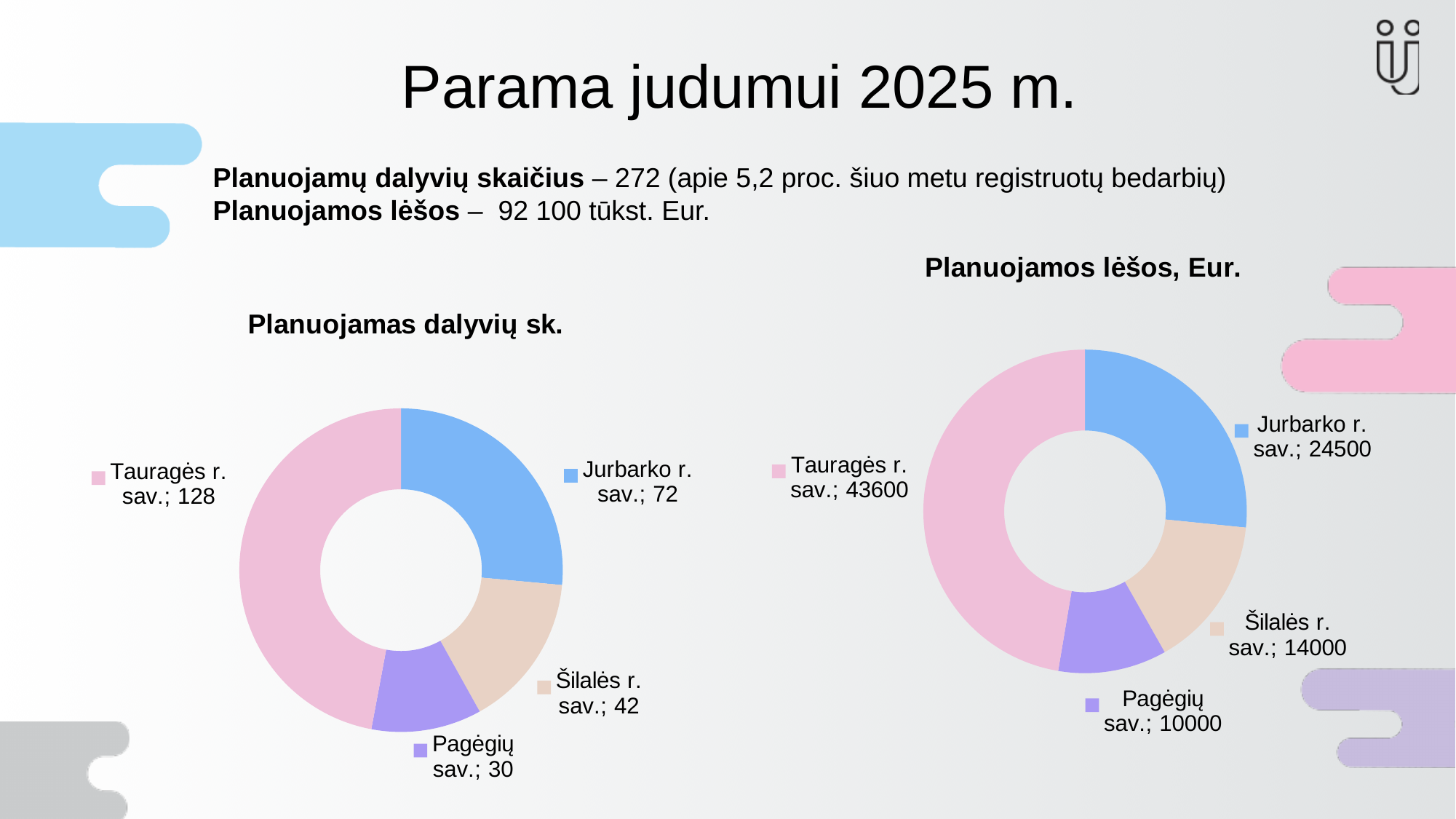
In the 'Planuojamos lėšos, Eur.' chart, what is the difference between Tauragės r. sav. and Jurbarko r. sav.? 19100 In the 'Planuojamos lėšos, Eur.' chart, what is the value for Jurbarko r. sav.? 24500 How many categories does the 'Planuojamas dalyvių sk.' chart show? 4 What kind of chart is the 'Planuojamos lėšos, Eur.' chart? Doughnut chart What is the total of all values in the 'Planuojamas dalyvių sk.' chart? 272 In the 'Planuojamos lėšos, Eur.' chart, which category has the lowest value? Pagėgių sav. In the 'Planuojamas dalyvių sk.' chart, what is the difference between Jurbarko r. sav. and Šilalės r. sav.? 30 In the 'Planuojamos lėšos, Eur.' chart, what is the value for Šilalės r. sav.? 14000 In the 'Planuojamos lėšos, Eur.' chart, which is larger: Šilalės r. sav. or Pagėgių sav.? Šilalės r. sav. In the 'Planuojamas dalyvių sk.' chart, which category has the highest value? Tauragės r. sav. In the 'Planuojamas dalyvių sk.' chart, what is the value for Pagėgių sav.? 30 In the 'Planuojamas dalyvių sk.' chart, what is the value for Tauragės r. sav.? 128